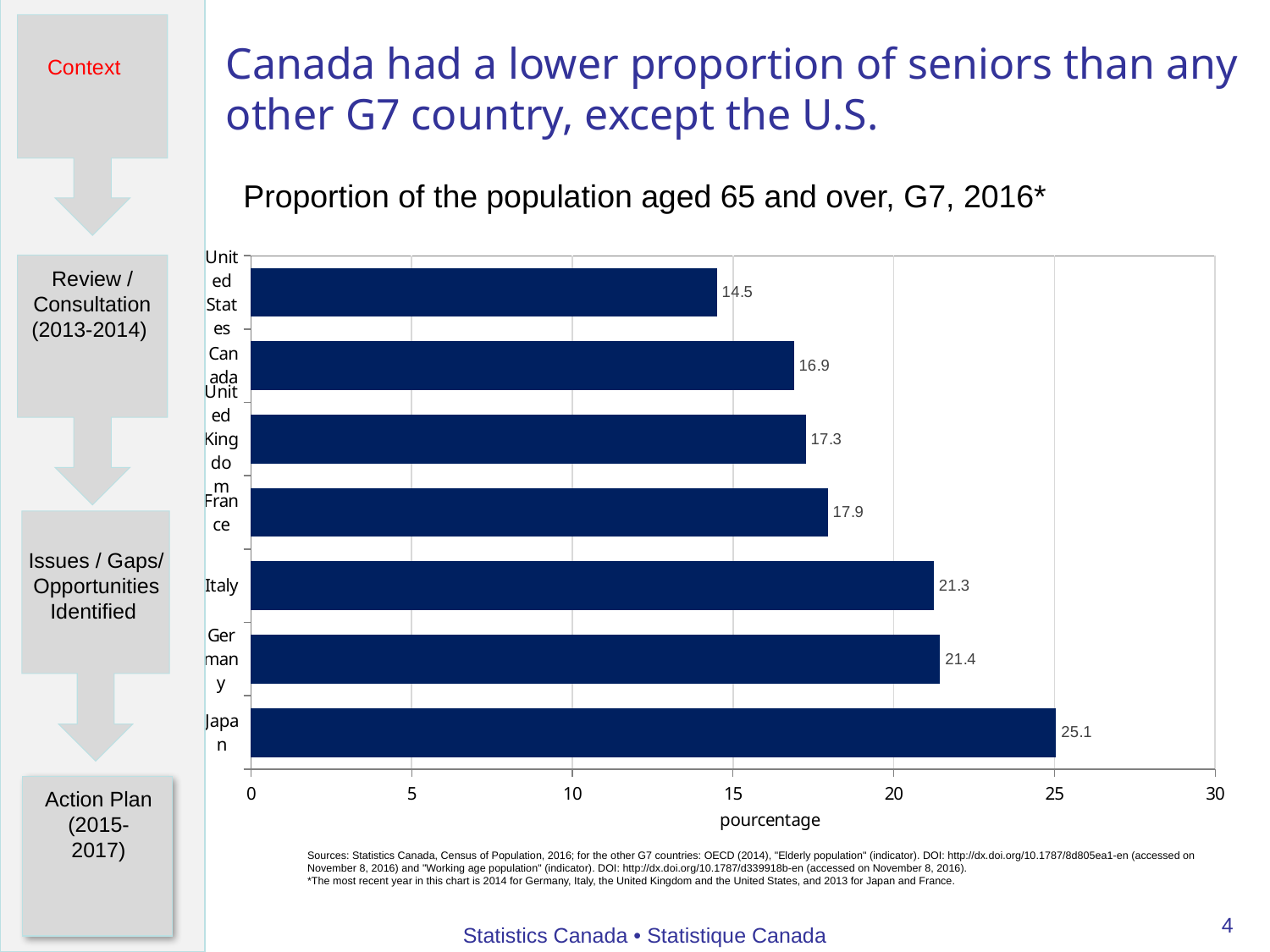
What is the proportion of the population aged 65 and over for Canada? 16.9 What is the difference between the values for Japan and the United States? 10.6 What is the value shown for the United Kingdom? 17.3 What is the value shown for Japan? 25.1 Which country has the highest proportion of the population aged 65 and over? Japan How many countries are shown in the chart? 7 Which has a larger value, Italy or France? Italy What is the label on the horizontal axis of the chart? pourcentage Which country has the lowest proportion of the population aged 65 and over? United States Is the value for Germany greater or less than 20? greater What is the difference between the values for Canada and France? 1.0 What kind of chart is shown on the slide? Bar chart